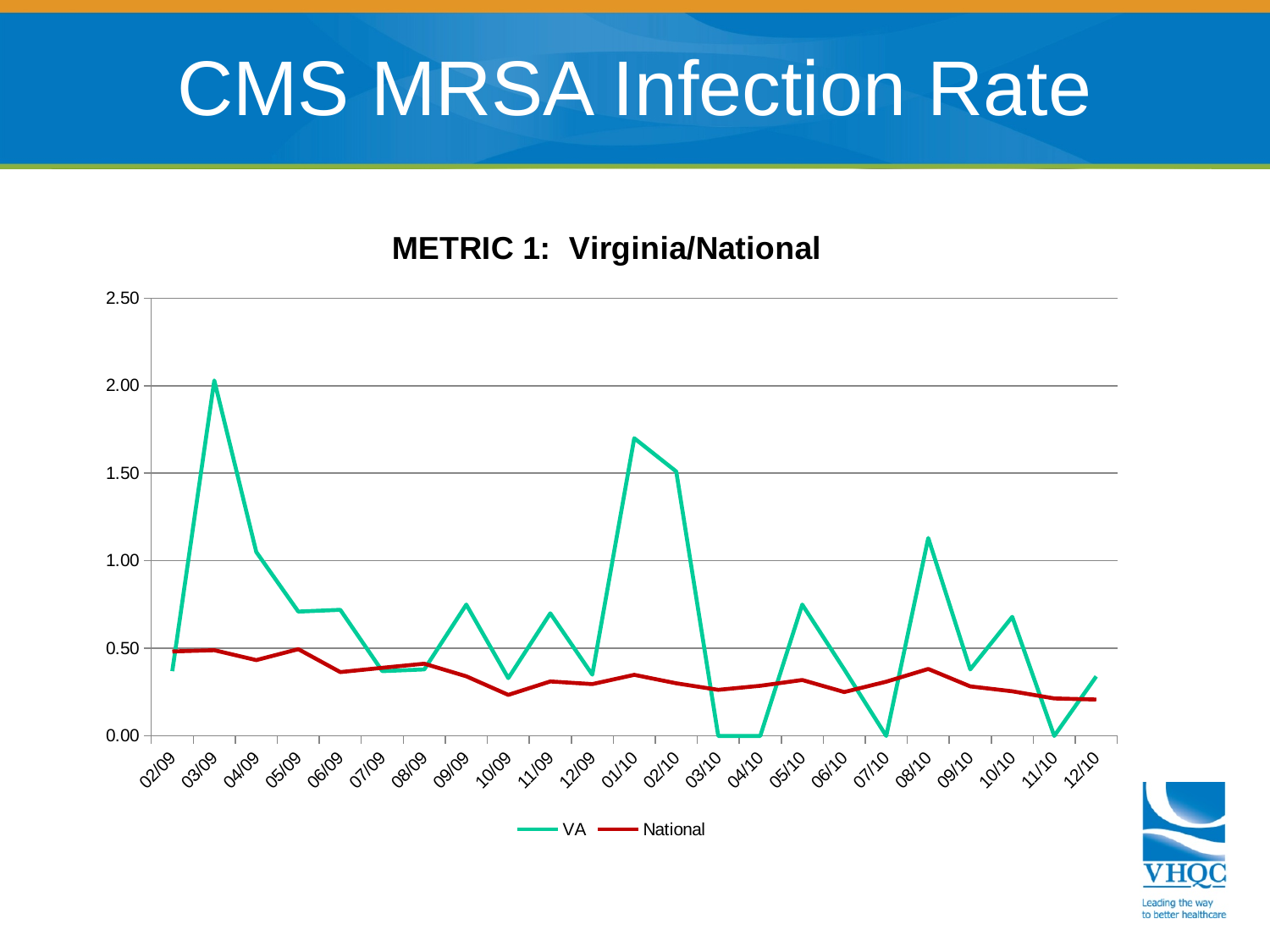
What is the VA value for 03/10? 0.00 In which month does the VA series reach its highest value? 03/09 Is the VA value for 01/10 greater or less than 1.50? greater Is the National value for 12/10 greater or less than 0.50? less Which series has the larger value in 03/09, VA or National? VA How many series does the legend list? 2 What kind of chart is shown on the slide? line chart How many months are plotted along the x axis? 23 What is the VA value for 11/10? 0.00 What are the two series named in the legend? VA and National Does the National series generally rise or fall from 02/09 to 12/10? fall Is the VA value for 08/10 greater or less than 1.00? greater